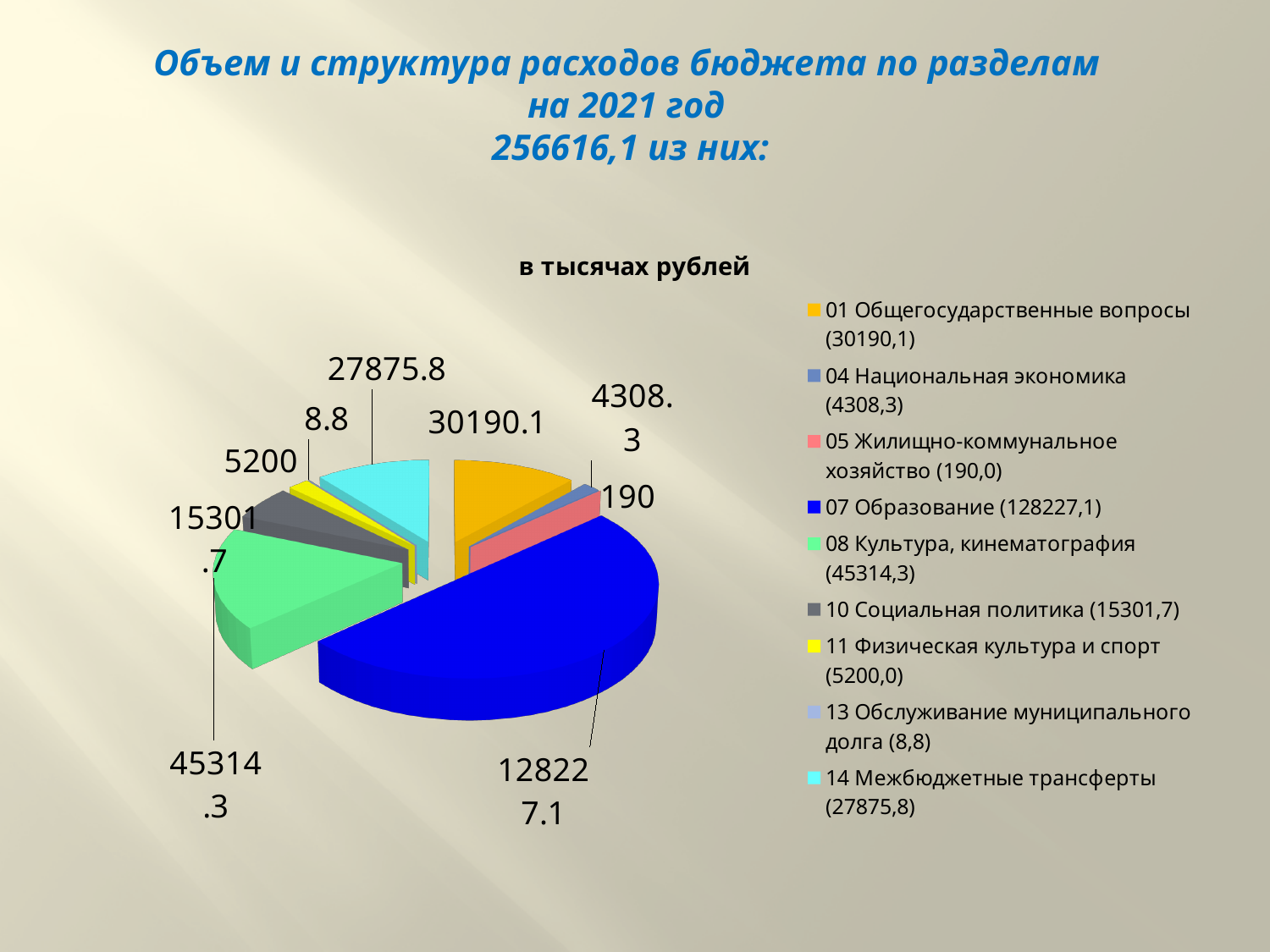
What is the difference between 08 Культура, кинематография and 10 Социальная политика? 30012.6 Which is larger: 01 Общегосударственные вопросы or 14 Межбюджетные трансферты? 01 Общегосударственные вопросы How many categories does the pie chart have? 9 Which category has the largest slice of the pie? 07 Образование What is the value for 05 Жилищно-коммунальное хозяйство? 190 Which category has the smallest value? 13 Обслуживание муниципального долга What kind of chart is shown on the slide? pie chart What is the value for 08 Культура, кинематография? 45314.3 What is the value for 14 Межбюджетные трансферты? 27875.8 What is the title of the chart? в тысячах рублей What is the difference between 11 Физическая культура и спорт and 05 Жилищно-коммунальное хозяйство? 5010 What is the value for 07 Образование? 128227.1